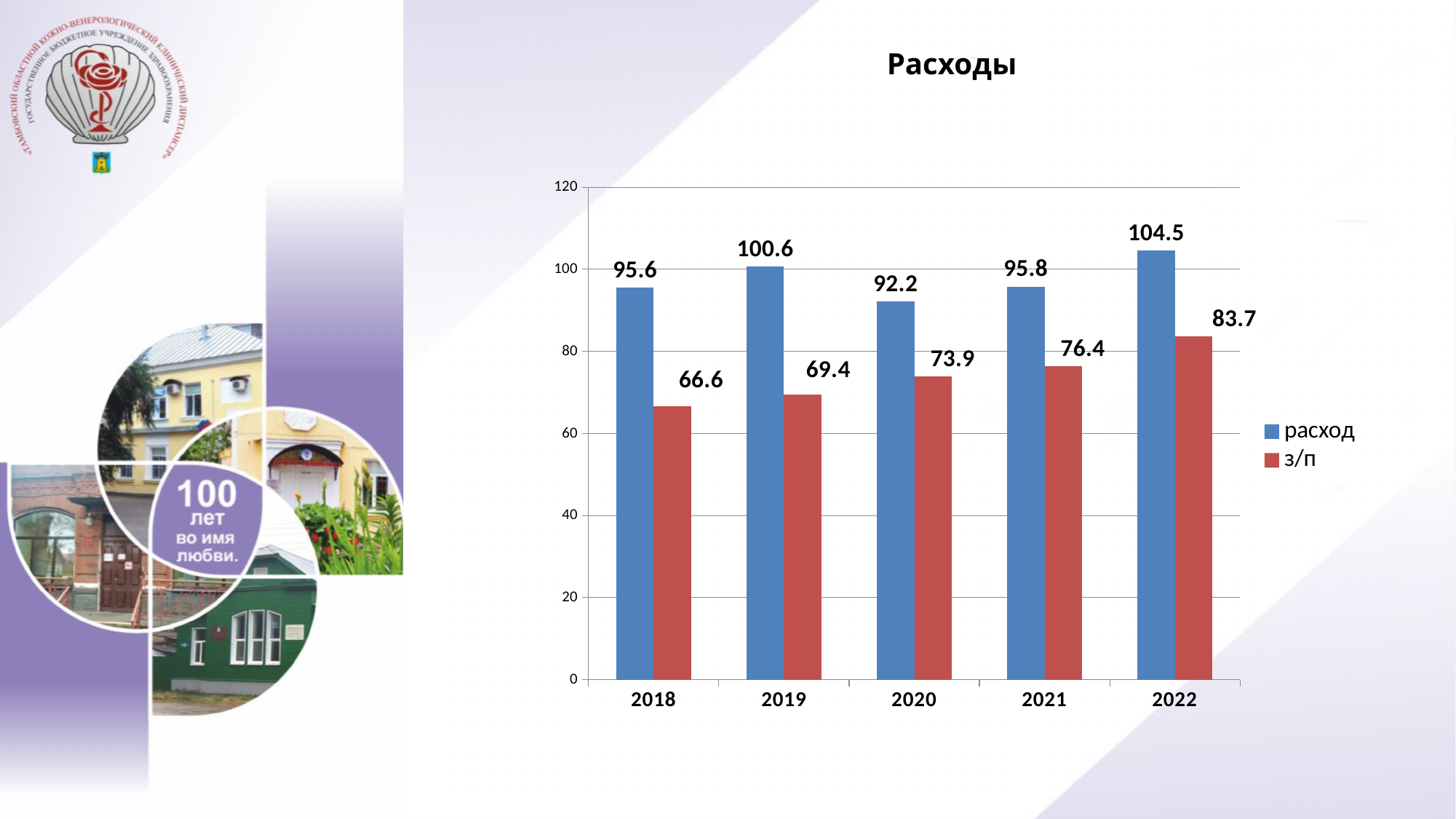
What is the value of расход for 2019? 100.6 In which year is расход highest? 2022 In which year is расход lowest? 2020 Does з/п rise or fall from 2018 to 2022? rise What is the value of з/п for 2022? 83.7 What is the difference between расход and з/п in 2020? 18.3 In which year is з/п lowest? 2018 How many series does the legend list? 2 Which is larger in 2021: расход or з/п? расход What kind of chart is shown on the slide? bar chart How many years are shown on the x axis? 5 What is the value of з/п for 2018? 66.6